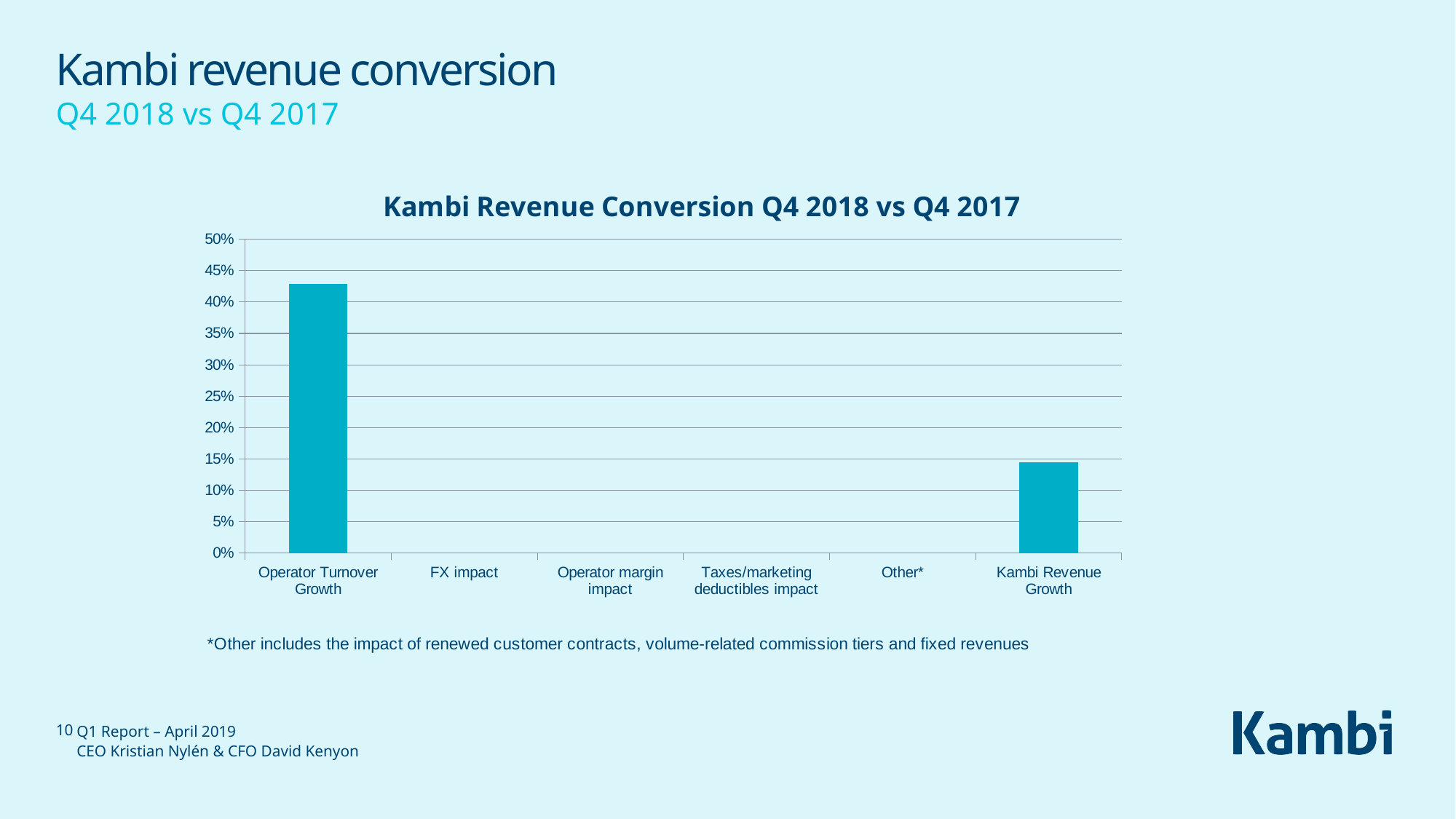
Is the value for Operator Turnover Growth greater or less than 40%? greater Is the value for Kambi Revenue Growth greater or less than 20%? less Which is larger, the bar for Operator Turnover Growth or the bar for Kambi Revenue Growth? Operator Turnover Growth Which category has the highest bar in the chart? Operator Turnover Growth What is the label of the first category on the x axis? Operator Turnover Growth What is the label of the last category on the x axis? Kambi Revenue Growth Is the value for Kambi Revenue Growth greater or less than 10%? greater What kind of chart is shown on the slide? Bar chart What is the highest value shown on the y axis of the chart? 50% What is the title of the chart? Kambi Revenue Conversion Q4 2018 vs Q4 2017 How many categories are shown on the x axis of the chart? 6